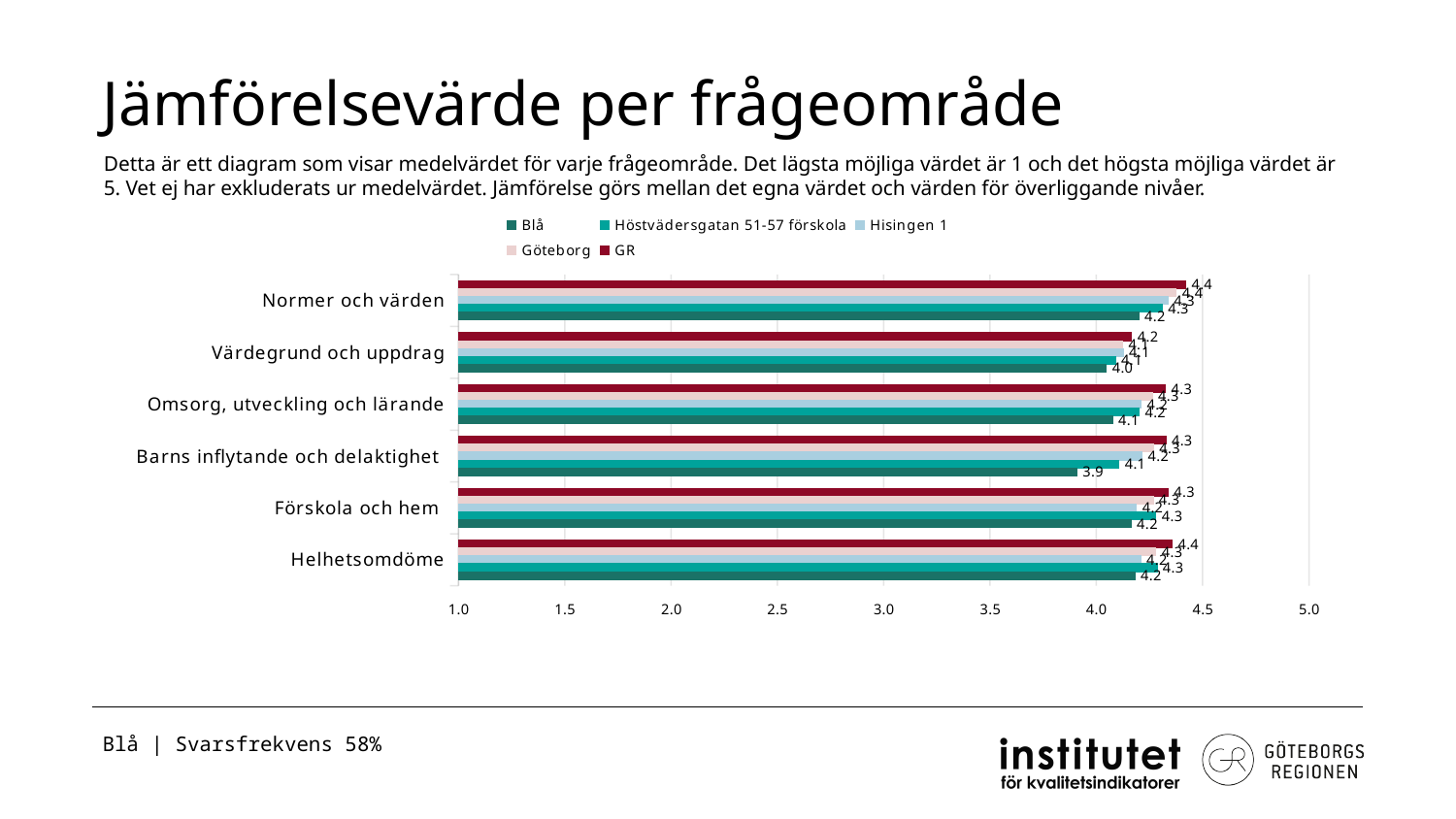
What is the difference between the Blå values for 'Normer och värden' and 'Barns inflytande och delaktighet'? 0.3 What is the value for Blå in 'Värdegrund och uppdrag'? 4.0 In which question area does Blå have its lowest value? Barns inflytande och delaktighet How many series does the legend list? 5 What is the value for Blå in 'Normer och värden'? 4.2 What kind of chart is shown on the slide? bar chart What is the value for Blå in 'Omsorg, utveckling och lärande'? 4.1 Which is larger for Blå: 'Normer och värden' or 'Barns inflytande och delaktighet'? Normer och värden What is the value for Höstvädersgatan 51-57 förskola in 'Barns inflytande och delaktighet'? 4.1 How many question areas (categories) are shown on the y axis? 6 Is the value for Blå in 'Barns inflytande och delaktighet' greater or less than 4.0? less What is the value for Blå in 'Barns inflytande och delaktighet'? 3.9